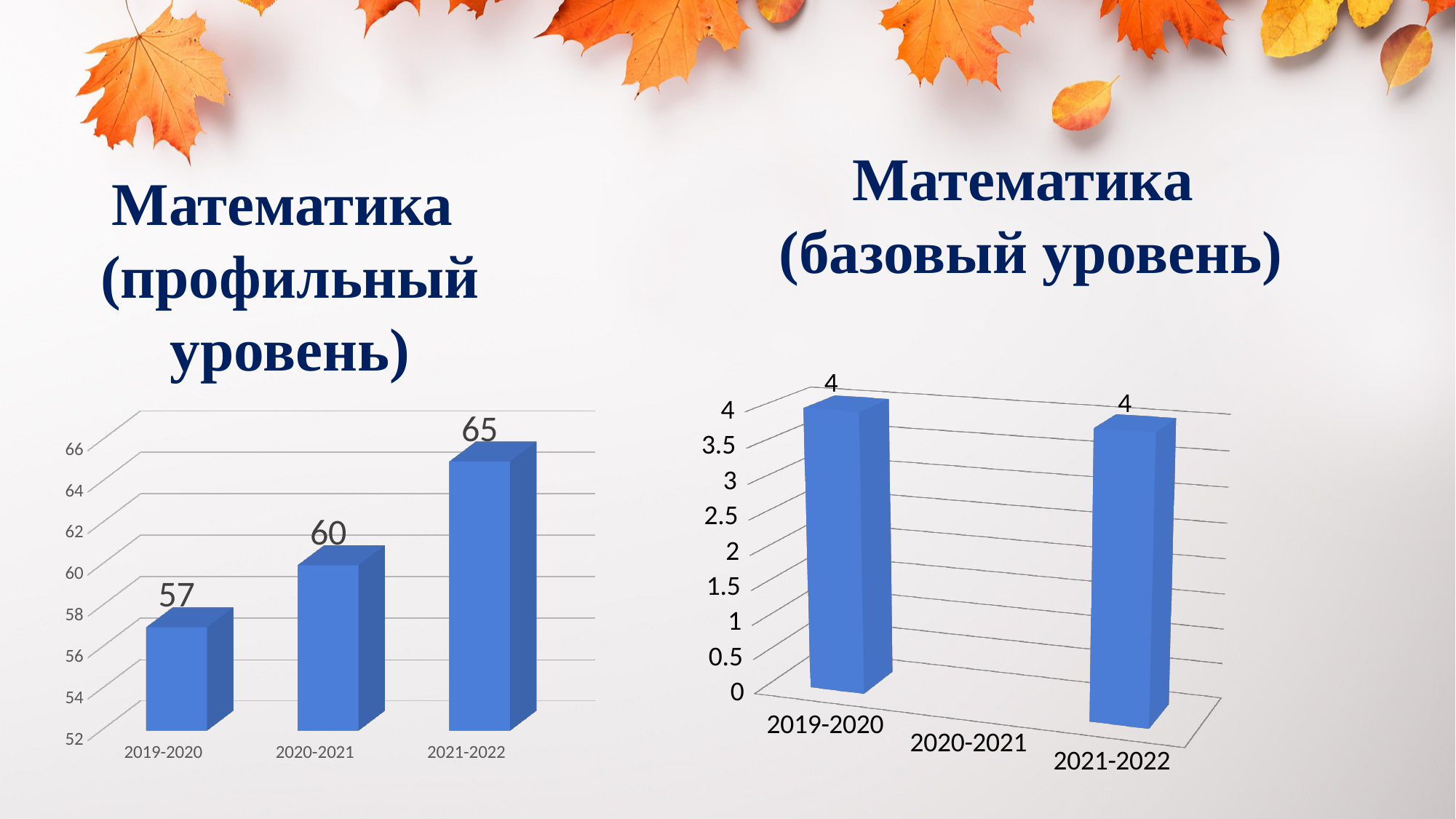
How many charts are on the slide? 2 In the chart titled "Математика (профильный уровень)", which category has the highest value? 2021-2022 In the chart titled "Математика (базовый уровень)", what is the value for 2021-2022? 4 In the chart titled "Математика (профильный уровень)", do the values rise or fall from 2019-2020 to 2021-2022? rise In the chart titled "Математика (профильный уровень)", what is the value for 2021-2022? 65 In the chart titled "Математика (профильный уровень)", which is larger, the value for 2020-2021 or the value for 2019-2020? 2020-2021 In the chart titled "Математика (профильный уровень)", how many categories are shown on the x axis? 3 What kind of chart is the chart titled "Математика (базовый уровень)"? bar chart In the chart titled "Математика (профильный уровень)", what is the value for 2019-2020? 57 In the chart titled "Математика (профильный уровень)", which category has the lowest value? 2019-2020 In the chart titled "Математика (профильный уровень)", what is the difference between the values for 2021-2022 and 2019-2020? 8 In the chart titled "Математика (базовый уровень)", what is the value for 2019-2020? 4